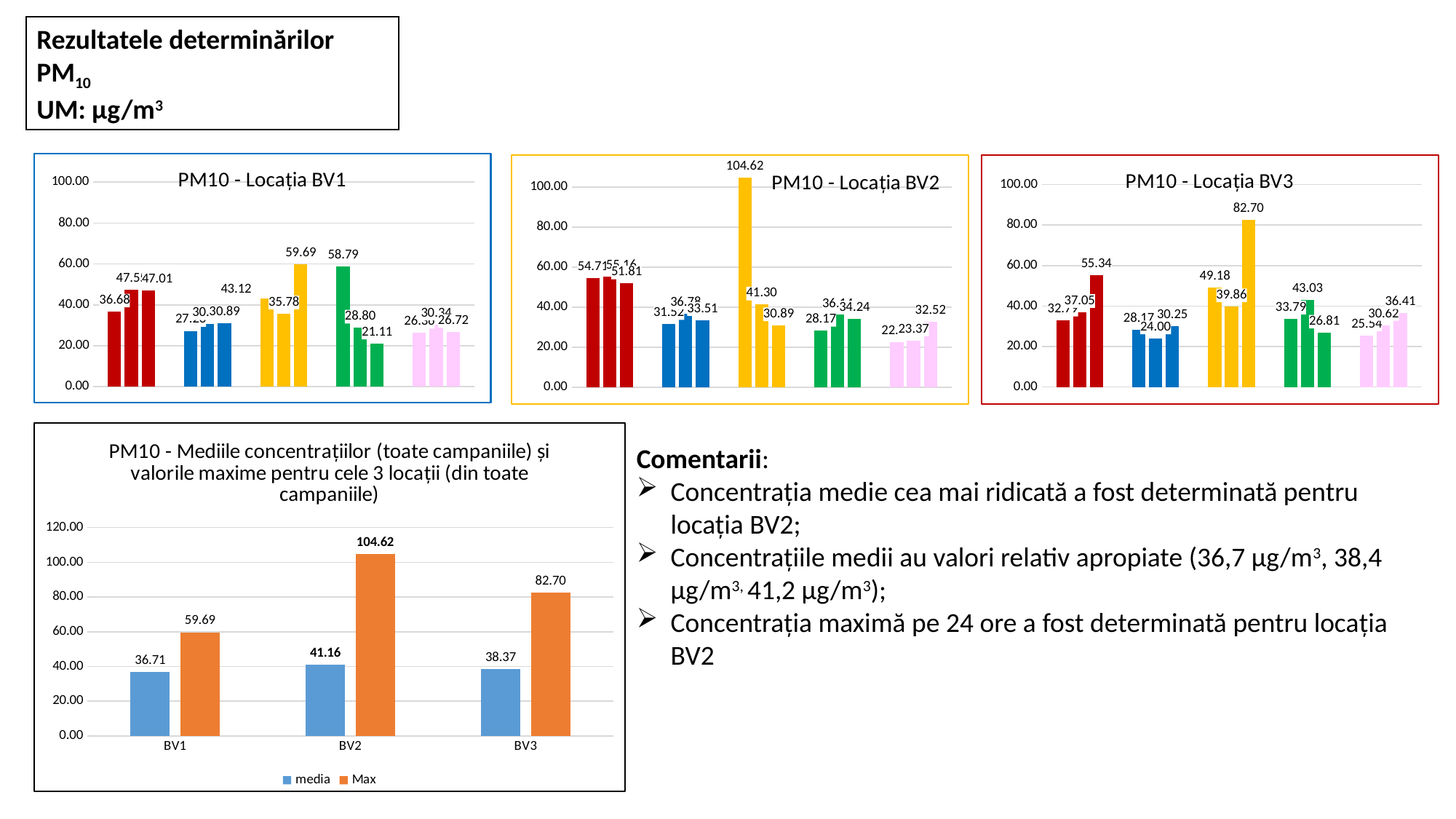
In the bottom chart 'PM10 - Mediile concentrațiilor', what is the 'Max' value for BV3? 82.70 In the top-middle chart 'PM10 - Locația BV2', what is the highest value shown? 104.62 In the bottom chart 'PM10 - Mediile concentrațiilor', what is the difference between the 'Max' and 'media' values for BV2? 63.46 In the bottom chart 'PM10 - Mediile concentrațiilor', is the 'media' value for BV3 larger or the 'media' value for BV1? BV3 What kind of chart is the bottom chart 'PM10 - Mediile concentrațiilor'? bar chart In the bottom chart 'PM10 - Mediile concentrațiilor', what is the 'Max' value for BV2? 104.62 In the bottom chart 'PM10 - Mediile concentrațiilor', which colour represents the 'Max' series? orange In the bottom chart 'PM10 - Mediile concentrațiilor', how many locations are shown on the x axis? 3 In the bottom chart 'PM10 - Mediile concentrațiilor', which location has the highest 'media' value? BV2 In the bottom chart 'PM10 - Mediile concentrațiilor', how many series does the legend list? 2 In the bottom chart 'PM10 - Mediile concentrațiilor', what is the 'media' value for BV1? 36.71 In the bottom chart 'PM10 - Mediile concentrațiilor', which location has the lowest 'Max' value? BV1